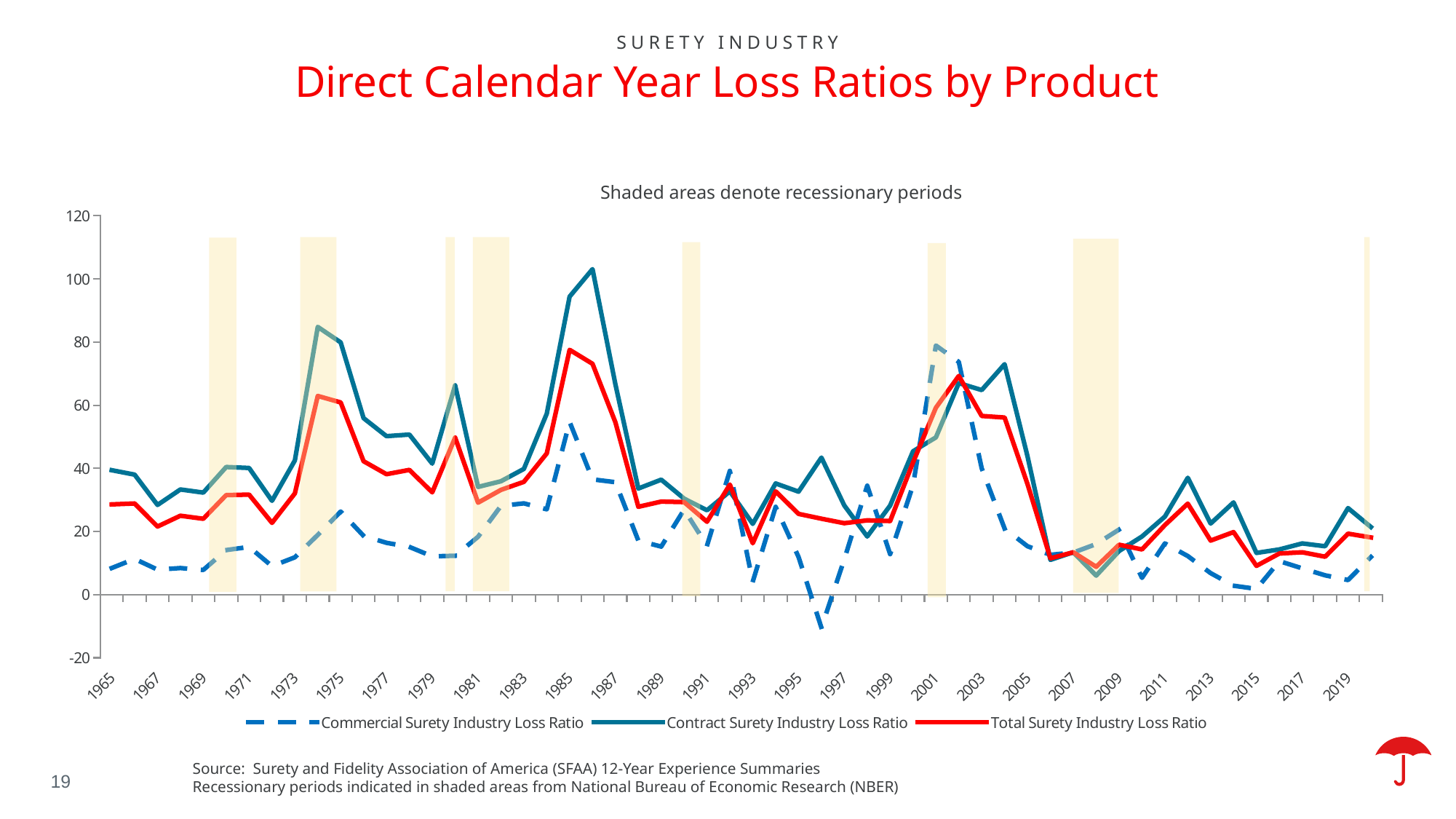
Does the Contract Surety Industry Loss Ratio rise or fall from 1986 to 1989? Fall Which series reaches the highest value anywhere on the chart? Contract Surety Industry Loss Ratio In 2001, which is larger: the Commercial Surety Industry Loss Ratio or the Contract Surety Industry Loss Ratio? Commercial Surety Industry Loss Ratio What kind of chart is shown on the slide? Line chart Is the Commercial Surety Industry Loss Ratio in 1965 greater or less than 20? less Is the Total Surety Industry Loss Ratio in 1985 greater or less than 60? greater In 1986, which is larger: the Contract Surety Industry Loss Ratio or the Commercial Surety Industry Loss Ratio? Contract Surety Industry Loss Ratio How many series does the legend list? 3 What is the title of the chart on the slide? Direct Calendar Year Loss Ratios by Product Is the Contract Surety Industry Loss Ratio in 1986 greater or less than 100? greater According to the note above the chart, what do the shaded areas denote? Recessionary periods Which series is the only one to fall below 0 on the chart? Commercial Surety Industry Loss Ratio